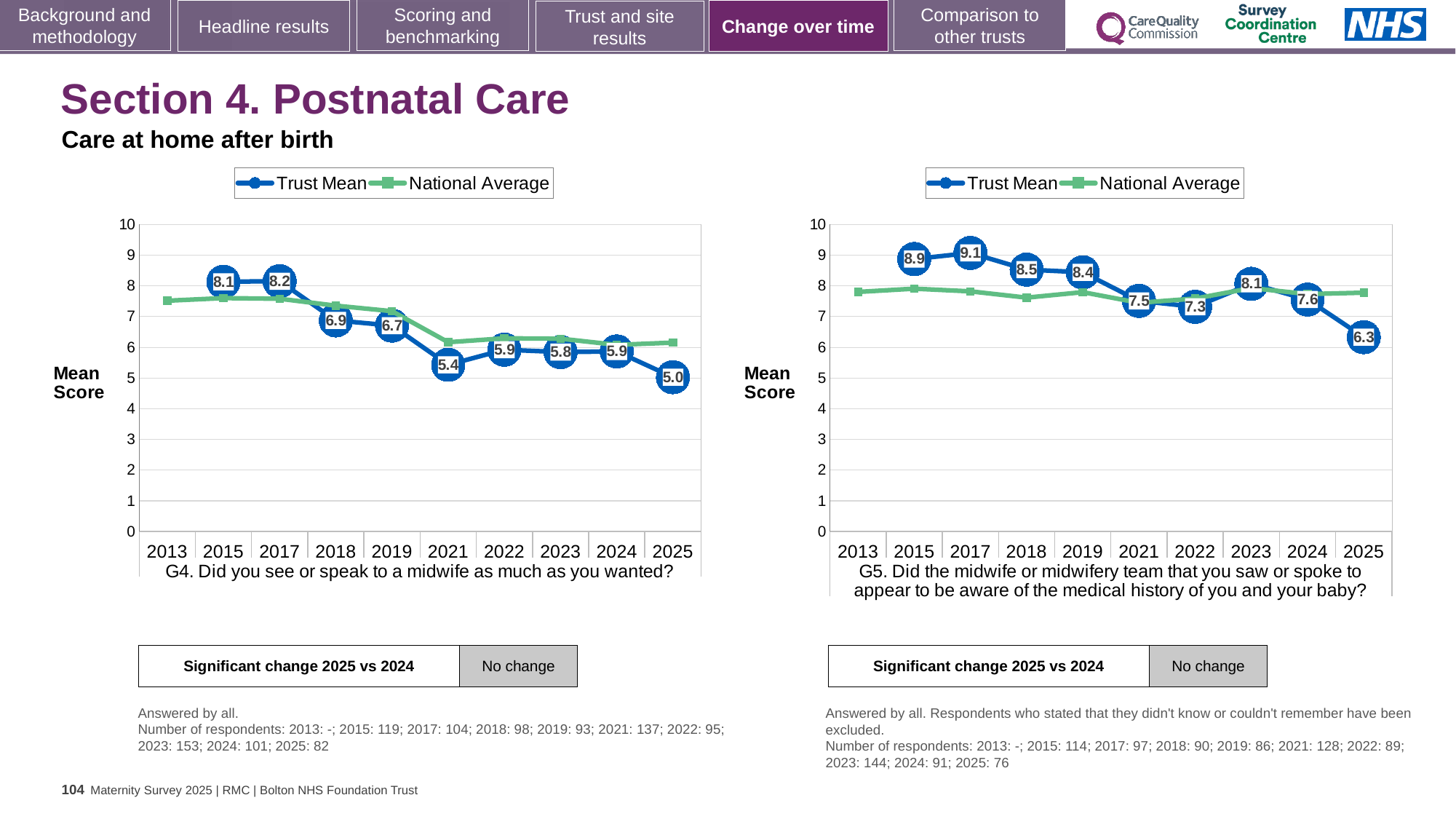
What kind of chart is the G5 chart on the right? Line chart In the G5 chart on the right, what is the difference between the Trust Mean scores for 2024 and 2025? 1.3 How many years are shown on the x axis of the G5 chart on the right? 10 In the G4 chart on the left, which is larger, the Trust Mean score for 2021 or for 2022? 2022 In the G4 chart on the left, what is the Trust Mean score for 2017? 8.2 In the G5 chart on the right, which year has the highest Trust Mean score? 2017 In the G4 chart on the left, which year has the lowest labelled Trust Mean score? 2025 In the G4 chart on the left, what is the Trust Mean score for 2025? 5.0 In the G5 chart on the right, what is the Trust Mean score for 2021? 7.5 In the G5 chart on the right, does the Trust Mean score rise or fall from 2023 to 2025? Fall How many series does the legend of the G4 chart on the left list? 2